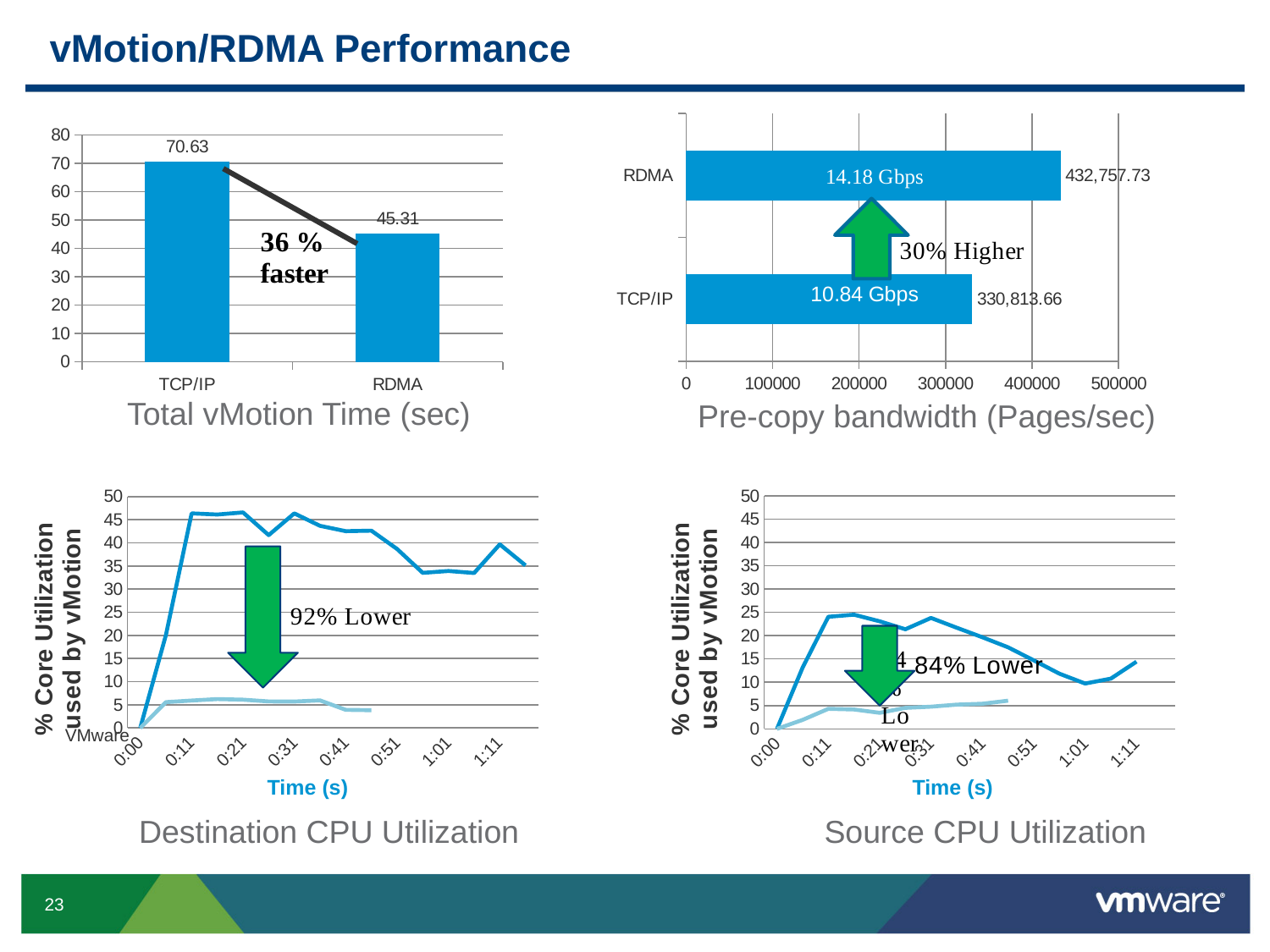
In the Pre-copy bandwidth (Pages/sec) chart, what bandwidth in Gbps is labelled on the TCP/IP bar? 10.84 Gbps In the Pre-copy bandwidth (Pages/sec) chart, how many categories are shown? 2 What kind of chart is the Total vMotion Time (sec) chart? Bar chart In the Pre-copy bandwidth (Pages/sec) chart, what is the value for RDMA? 432,757.73 In the Source CPU Utilization chart, is the peak value of the upper line greater or less than 30? less In the Pre-copy bandwidth (Pages/sec) chart, which category has the higher value? RDMA In the Destination CPU Utilization chart, is the peak value of the upper line greater or less than 40? greater In the Total vMotion Time (sec) chart, which category has the lower value? RDMA In the Total vMotion Time (sec) chart, what is the difference between the TCP/IP and RDMA values? 25.32 In the Total vMotion Time (sec) chart, what is the value for RDMA? 45.31 In the Pre-copy bandwidth (Pages/sec) chart, what is the value for TCP/IP? 330,813.66 In the Total vMotion Time (sec) chart, what is the value for TCP/IP? 70.63